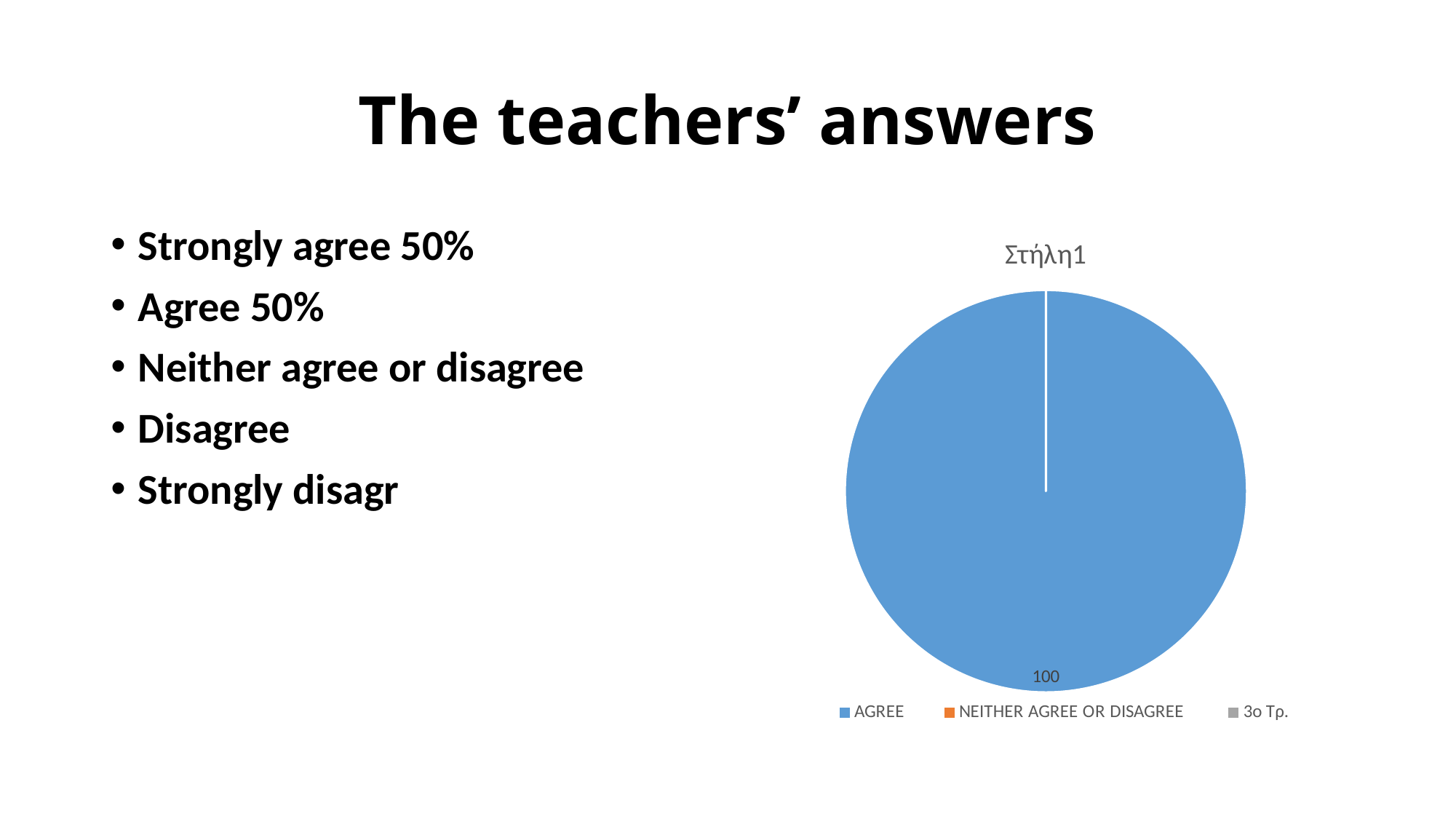
How many entries does the pie chart's legend list? 3 What kind of chart is shown on the slide? pie chart Is the value for AGREE in the pie chart greater or less than 50? greater What colour is the AGREE slice in the pie chart? blue Which category takes up the largest share of the pie chart? AGREE What share of the pie does the AGREE slice represent? 100% What value is printed on the AGREE slice of the pie chart? 100 What is the title of the pie chart? Στήλη1